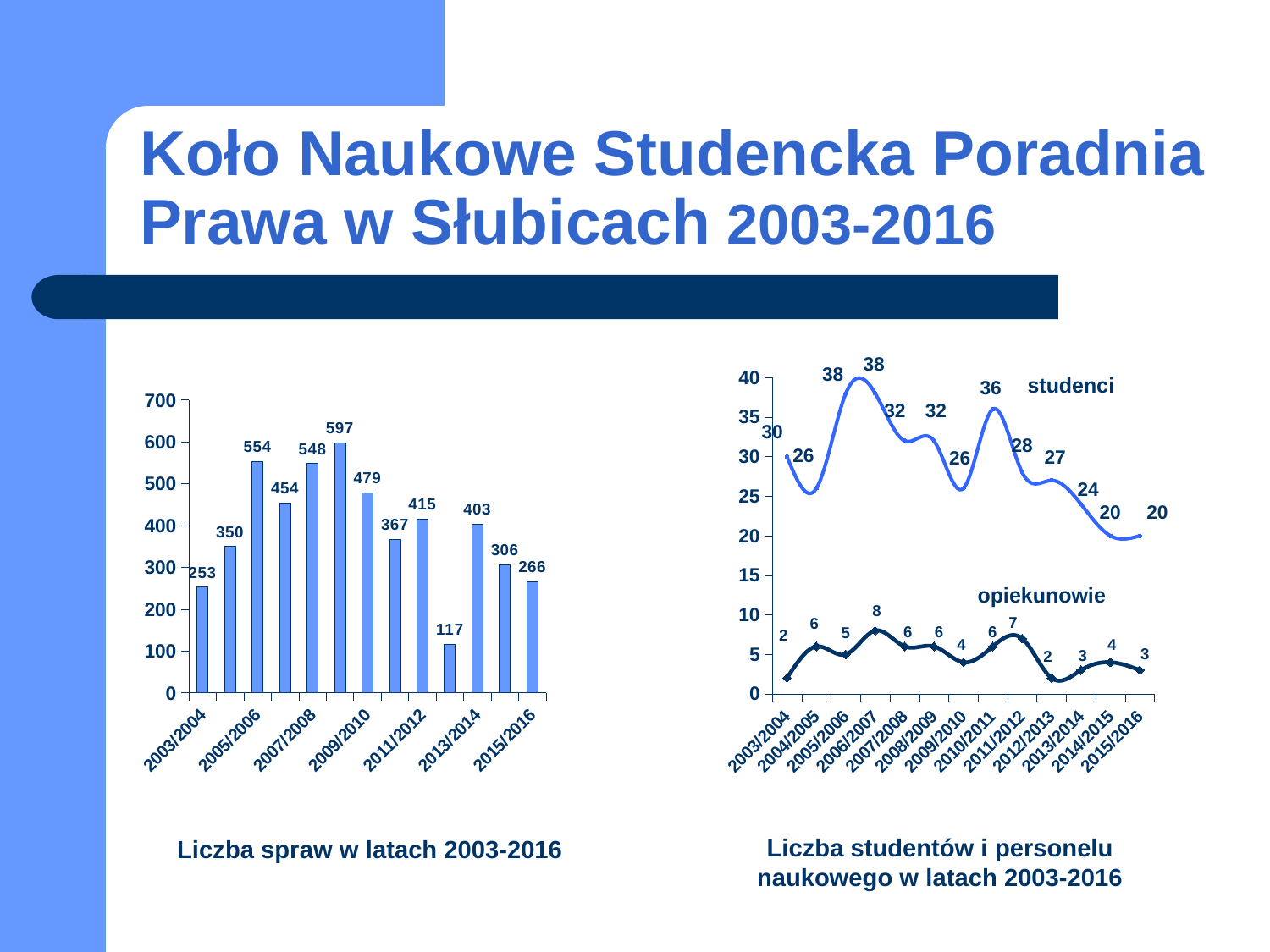
In the left chart 'Liczba spraw w latach 2003-2016', what is the difference between the values for 2005/2006 and 2007/2008? 6 In the left chart 'Liczba spraw w latach 2003-2016', what is the highest value shown? 597 How many bars are in the left chart 'Liczba spraw w latach 2003-2016'? 13 In the right chart 'Liczba studentów i personelu naukowego w latach 2003-2016', in which year is the opiekunowie value highest? 2006/2007 In the right chart 'Liczba studentów i personelu naukowego w latach 2003-2016', what is the value for studenci in 2006/2007? 38 What type of chart is the left chart titled 'Liczba spraw w latach 2003-2016'? bar chart In the left chart 'Liczba spraw w latach 2003-2016', which is larger, the value for 2009/2010 or for 2011/2012? 2009/2010 How many series are plotted in the right chart 'Liczba studentów i personelu naukowego w latach 2003-2016'? 2 In the left chart 'Liczba spraw w latach 2003-2016', what is the value for 2015/2016? 266 In the right chart 'Liczba studentów i personelu naukowego w latach 2003-2016', what is the difference between the studenci values for 2003/2004 and 2015/2016? 10 In the left chart 'Liczba spraw w latach 2003-2016', what is the lowest value shown? 117 In the left chart 'Liczba spraw w latach 2003-2016', what is the value for 2003/2004? 253